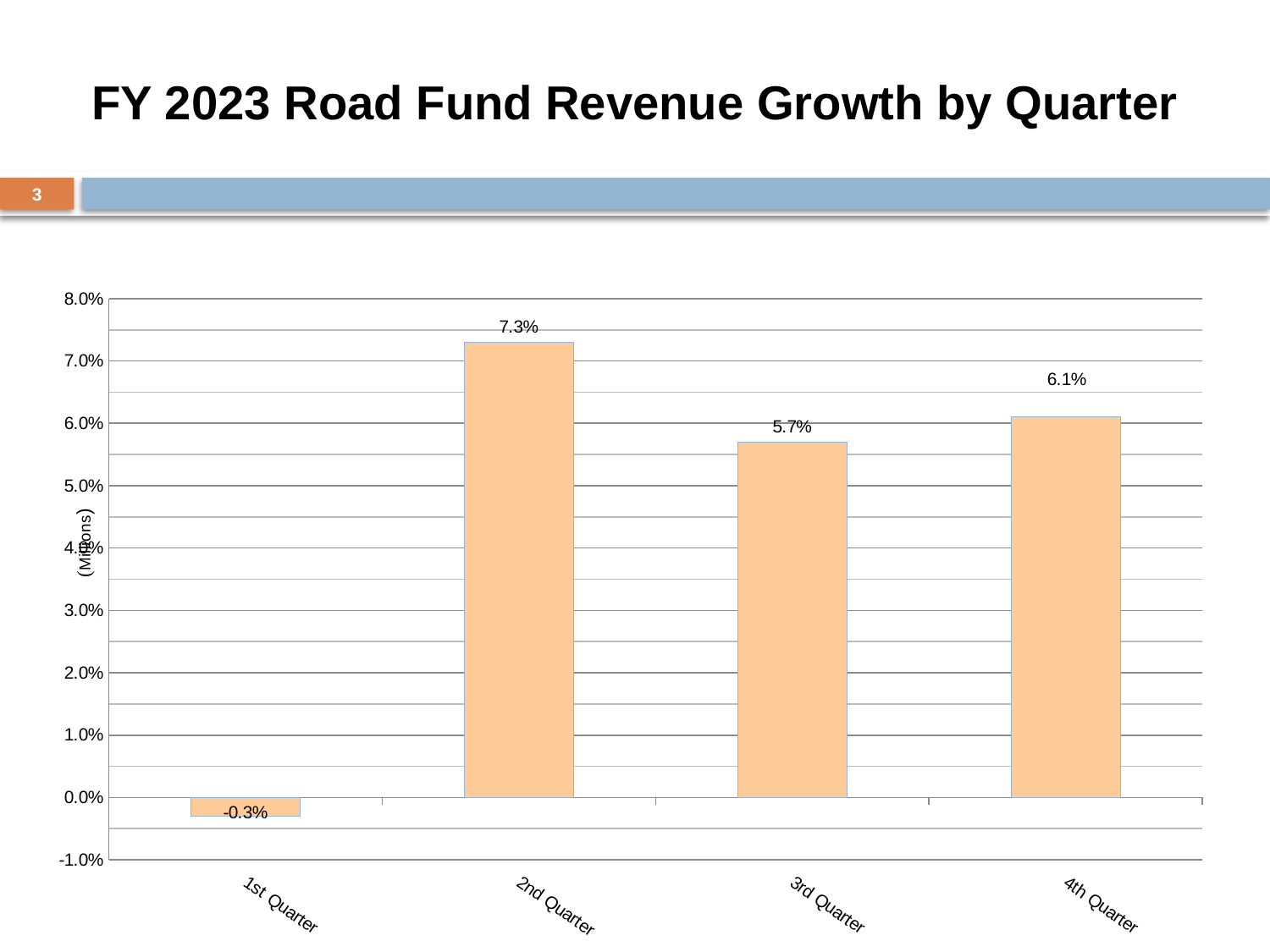
What is the title of the slide? FY 2023 Road Fund Revenue Growth by Quarter Which is larger, the growth for the 3rd Quarter or the 4th Quarter? 4th Quarter Which quarter has the highest revenue growth? 2nd Quarter Which quarter has the lowest revenue growth? 1st Quarter What is the revenue growth value for the 1st Quarter? -0.3% What kind of chart is shown on the slide? Bar chart Does the growth value rise or fall from the 2nd Quarter to the 3rd Quarter? Fall What is the revenue growth value for the 2nd Quarter? 7.3% What is the difference between the 2nd Quarter and 3rd Quarter growth values? 1.6% How many quarters are shown on the chart? 4 Is the value for the 3rd Quarter greater or less than 5.0%? greater What is the revenue growth value for the 4th Quarter? 6.1%